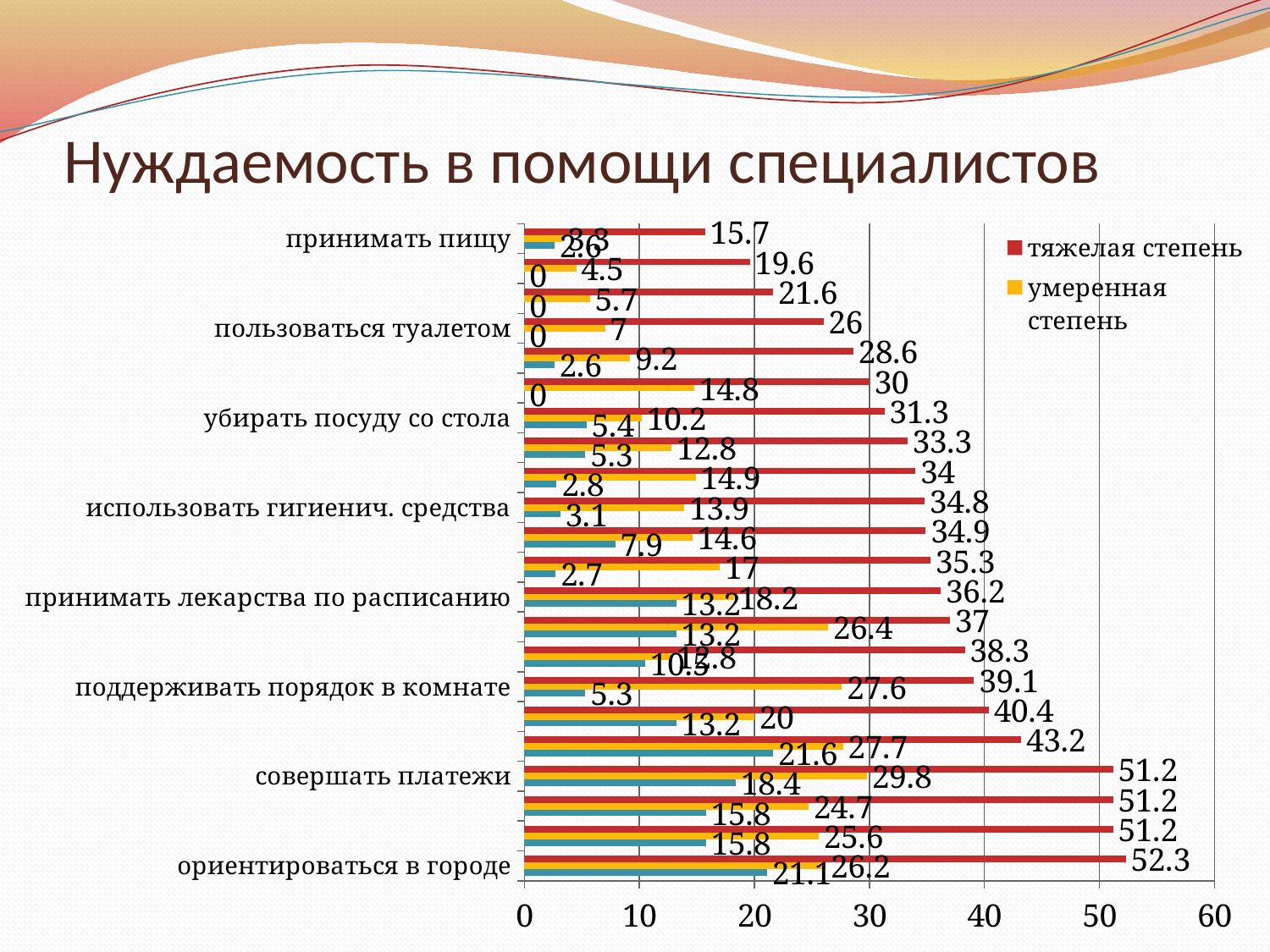
How many series does the legend list? 2 What is the value of 'умеренная степень' for 'совершать платежи'? 29.8 What is the value of 'умеренная степень' for 'использовать гигиенич. средства'? 13.9 What is the value of 'тяжелая степень' for 'пользоваться туалетом'? 26 For 'убирать посуду со стола', what is the difference between 'тяжелая степень' and 'умеренная степень'? 21.1 Which has a higher 'тяжелая степень' value: 'совершать платежи' or 'принимать лекарства по расписанию'? совершать платежи What is the value of 'тяжелая степень' for 'ориентироваться в городе'? 52.3 What is the value of 'умеренная степень' for 'поддерживать порядок в комнате'? 27.6 Is the 'тяжелая степень' value for 'использовать гигиенич. средства' greater or less than 30? greater What type of chart is shown on the slide? bar chart Which labeled category has the lowest 'тяжелая степень' value? принимать пищу Which labeled category has the highest 'тяжелая степень' value? ориентироваться в городе